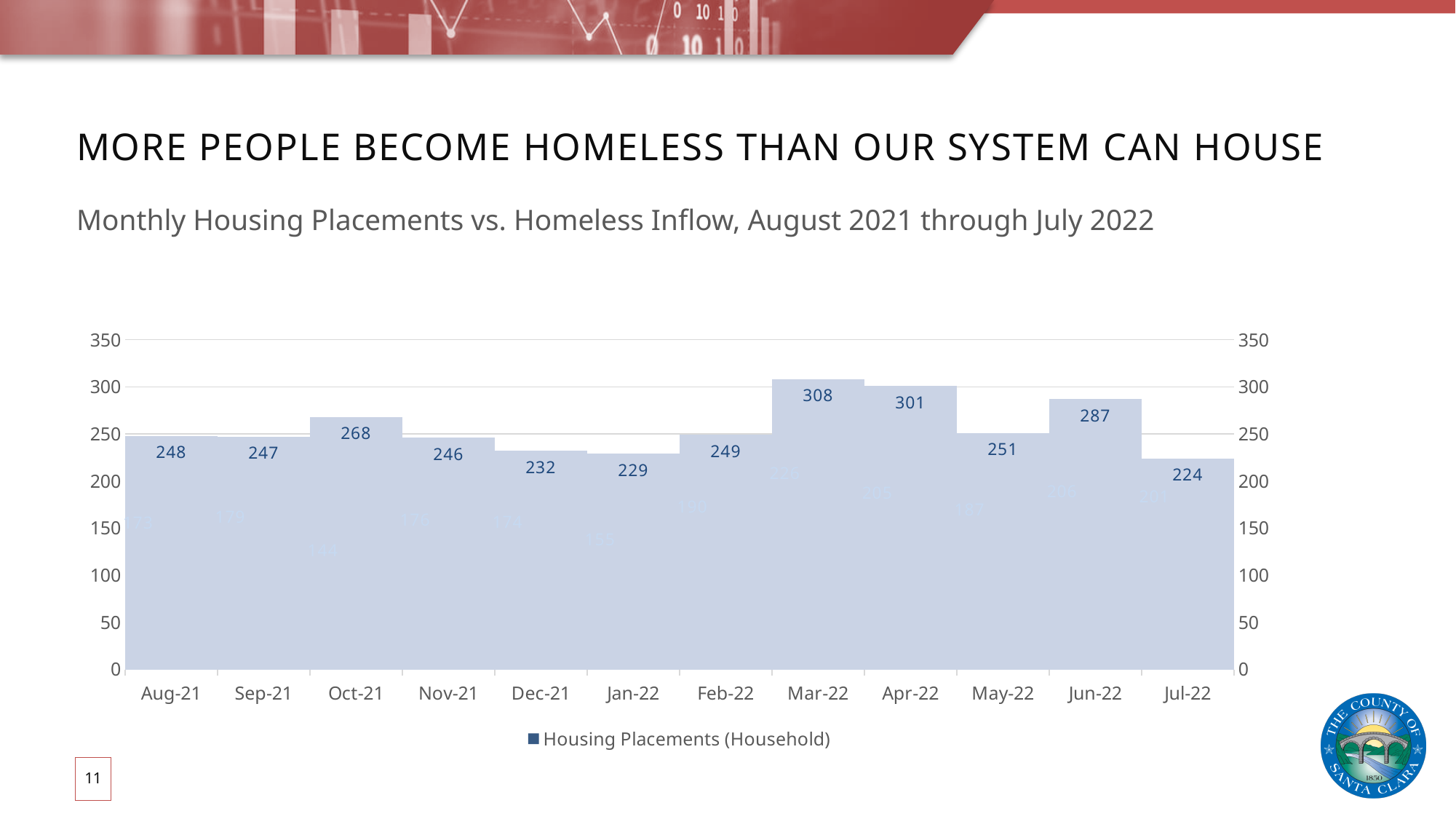
What is the name of the series shown in the legend? Housing Placements (Household) What is the difference between the values for Oct-21 and Nov-21? 22 Which month has the highest value? Mar-22 Which is larger, the value for Oct-21 or the value for Jun-22? Jun-22 Is the value for Jan-22 greater or less than 250? less How many months are shown on the x axis? 12 What is the value for Mar-22? 308 What is the difference between the values for Mar-22 and Jul-22? 84 How many series does the legend list? 1 Which month has the lowest value? Jul-22 What is the value for Jul-22? 224 What is the value for Dec-21? 232